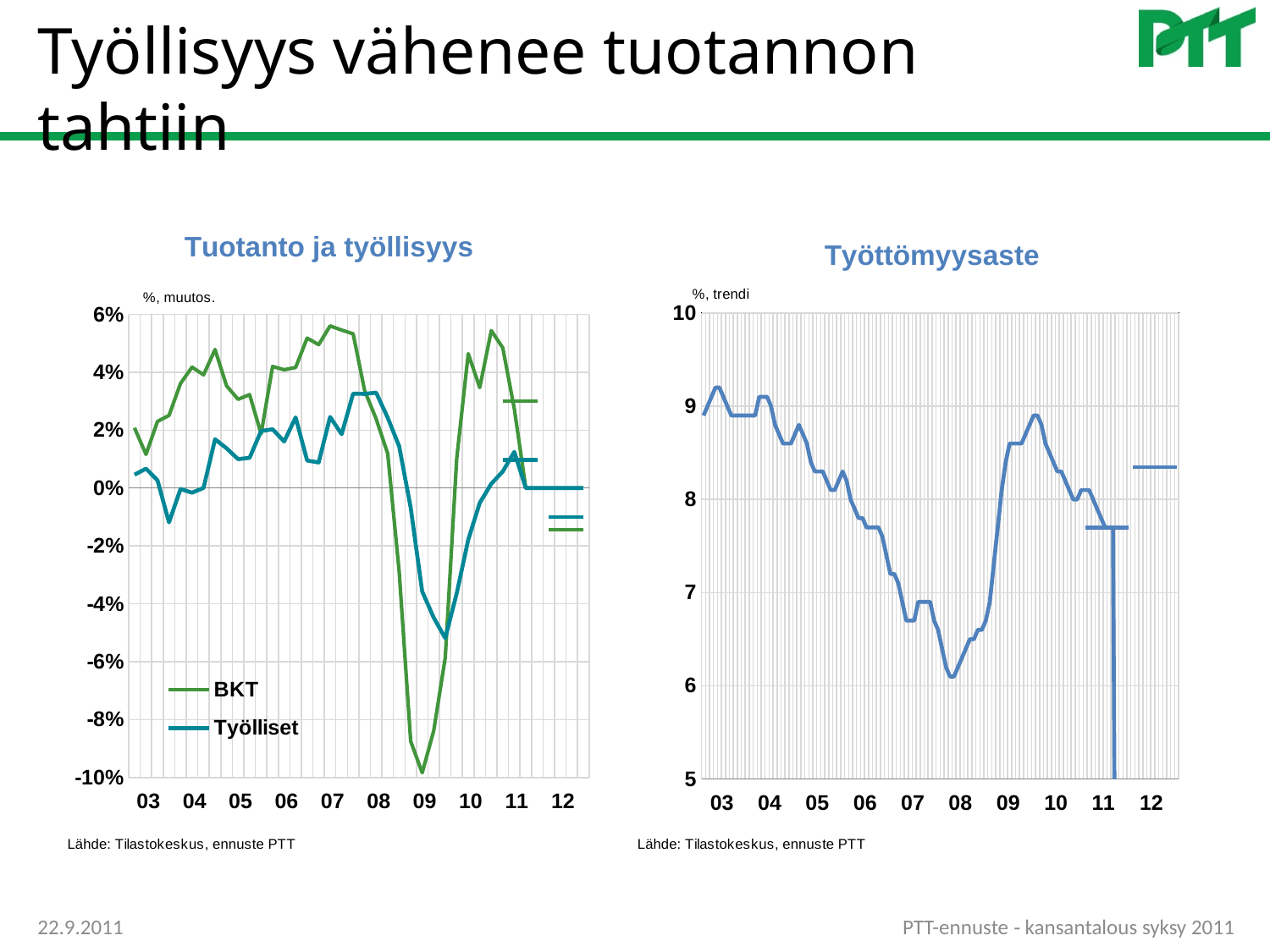
In the left chart "Tuotanto ja työllisyys", is the lowest value of the Työlliset series around 2009 greater or less than -2%? less What unit label is shown above the y axis of the right chart "Työttömyysaste"? %, trendi In the right chart "Työttömyysaste", is the value at the start of 2003 greater or less than 8? greater In the left chart "Tuotanto ja työllisyys", what are the two series named in the legend? BKT and Työlliset In the left chart "Tuotanto ja työllisyys", which series falls to a lower value in 2009, BKT or Työlliset? BKT In the left chart "Tuotanto ja työllisyys", is the lowest value of the BKT series around 2009 greater or less than -8%? less In the right chart "Työttömyysaste", does the unemployment rate rise or fall from 2003 to 2008? fall What kind of chart is the left chart titled "Tuotanto ja työllisyys"? line chart In the left chart "Tuotanto ja työllisyys", how many series does the legend list? 2 What kind of chart is the right chart titled "Työttömyysaste"? line chart